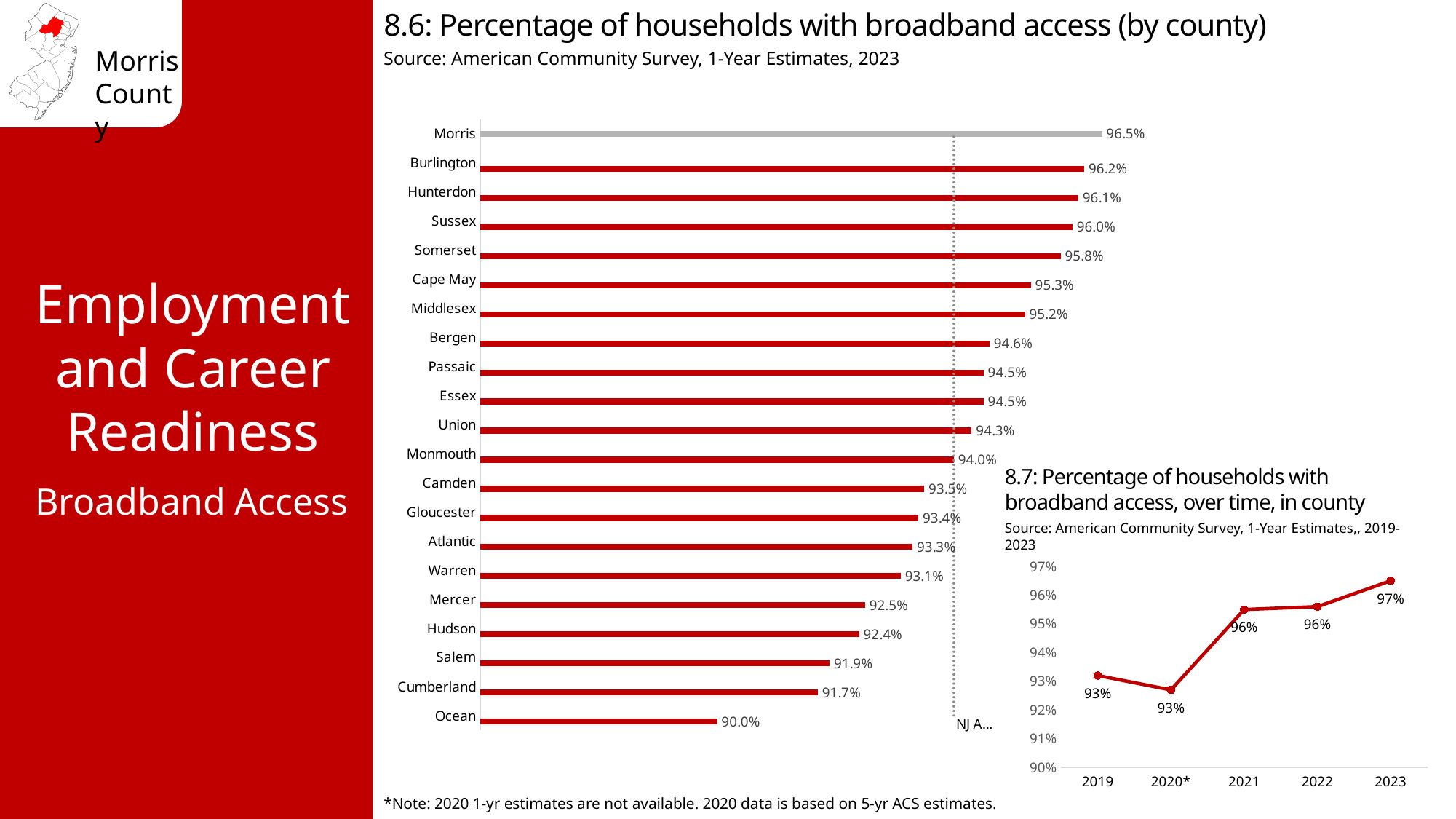
In chart 8.6, how many counties are shown? 21 In chart 8.6, what is the value for Cumberland? 91.7% In chart 8.6, which county has a higher value, Bergen or Mercer? Bergen What kind of chart is chart 8.6? Bar chart In chart 8.6, what percentage of households in Somerset have broadband access? 95.8% In chart 8.7, do the values generally rise or fall from 2019 to 2023? Rise In chart 8.6, what is the difference between the values for Morris and Ocean? 6.5 percentage points In chart 8.7, how many years are plotted? 5 In chart 8.6, which county has the lowest percentage of households with broadband access? Ocean In chart 8.7, what was the percentage of households with broadband access in 2021? 96% In chart 8.6, which county has the highest percentage of households with broadband access? Morris In chart 8.7, which year has the highest value? 2023